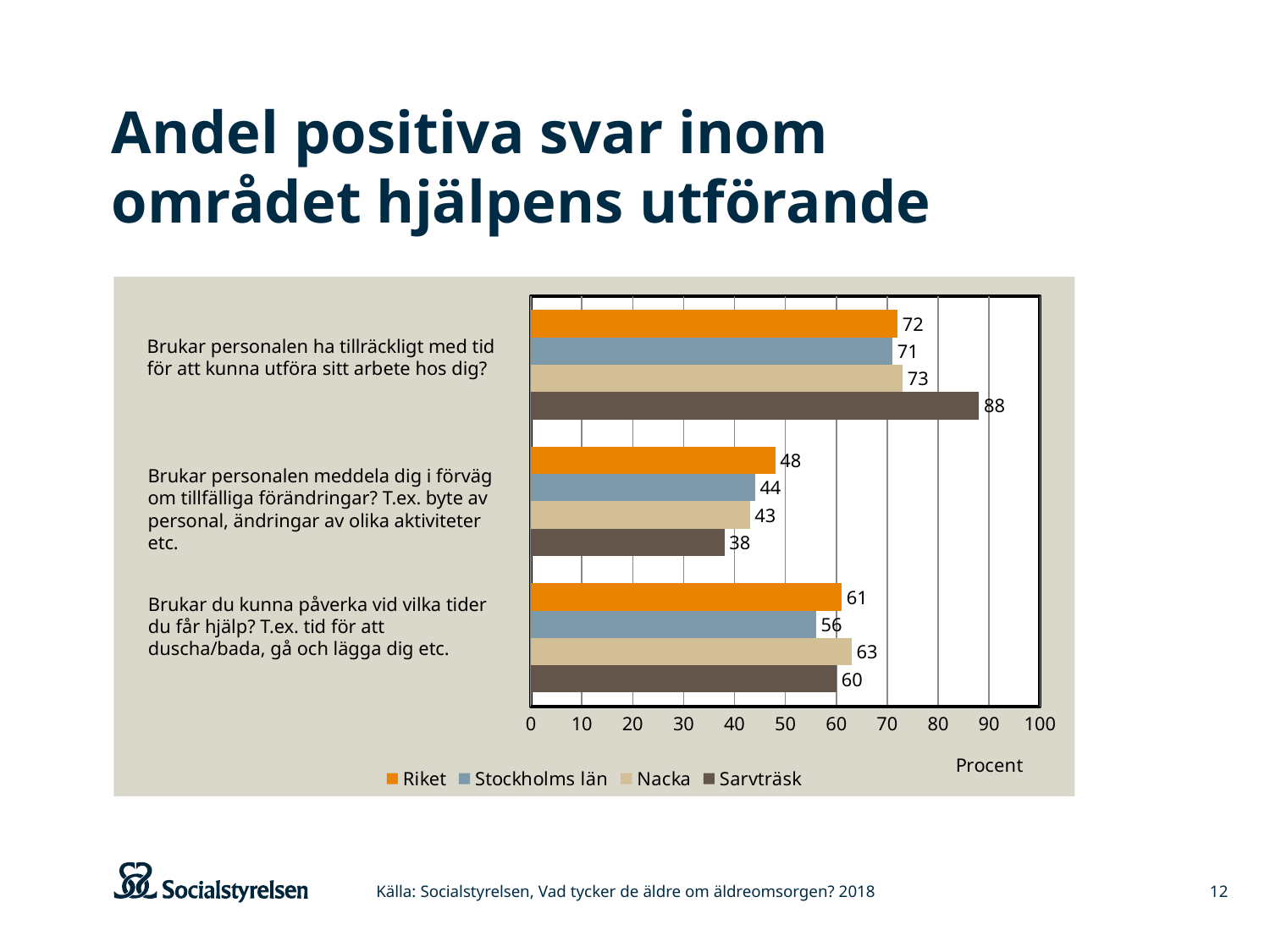
What is the value for Stockholms län on the question "Brukar du kunna påverka vid vilka tider du får hjälp?"? 56 What unit is shown on the x axis of the chart? Procent How many series does the legend list? 4 What is the value for Nacka on the question "Brukar du kunna påverka vid vilka tider du får hjälp?"? 63 How many questions (categories) are shown on the chart? 3 Which series has the lowest value on the question "Brukar personalen meddela dig i förväg om tillfälliga förändringar?"? Sarvträsk What kind of chart is shown on the slide? Bar chart What is the value for Sarvträsk on the question "Brukar personalen ha tillräckligt med tid för att kunna utföra sitt arbete hos dig?"? 88 Which is larger on the question "Brukar personalen meddela dig i förväg om tillfälliga förändringar?": Riket or Sarvträsk? Riket What is the value for Riket on the question "Brukar personalen meddela dig i förväg om tillfälliga förändringar?"? 48 Which series has the highest value on the question "Brukar personalen ha tillräckligt med tid för att kunna utföra sitt arbete hos dig?"? Sarvträsk What is the difference between Sarvträsk and Riket on the question "Brukar personalen ha tillräckligt med tid för att kunna utföra sitt arbete hos dig?"? 16